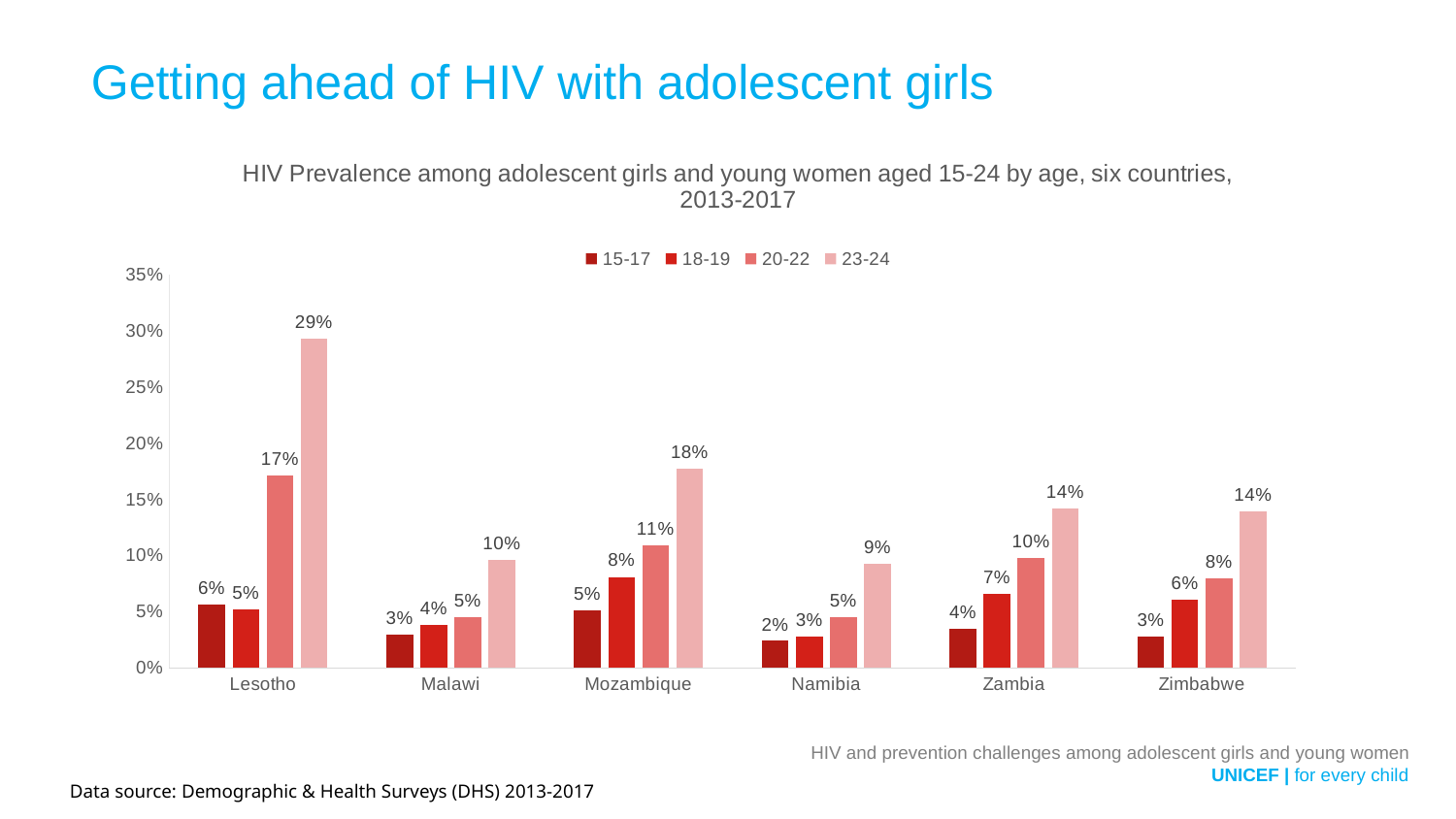
What kind of chart is shown on the slide? Bar chart Which country has the lowest HIV prevalence for the 15-17 age group? Namibia How many age groups does the legend list? 4 What is the HIV prevalence for the 23-24 age group in Lesotho? 29% What is the HIV prevalence for the 20-22 age group in Zambia? 10% What is the difference between the 23-24 and 20-22 values for Lesotho? 12% What is the HIV prevalence for the 18-19 age group in Mozambique? 8% Which is larger: the 23-24 value for Mozambique or the 23-24 value for Zambia? Mozambique How many countries are shown on the x axis? 6 What is the HIV prevalence for the 15-17 age group in Namibia? 2% Which country has the highest HIV prevalence for the 23-24 age group? Lesotho What is the data source cited on the slide? Demographic & Health Surveys (DHS) 2013-2017